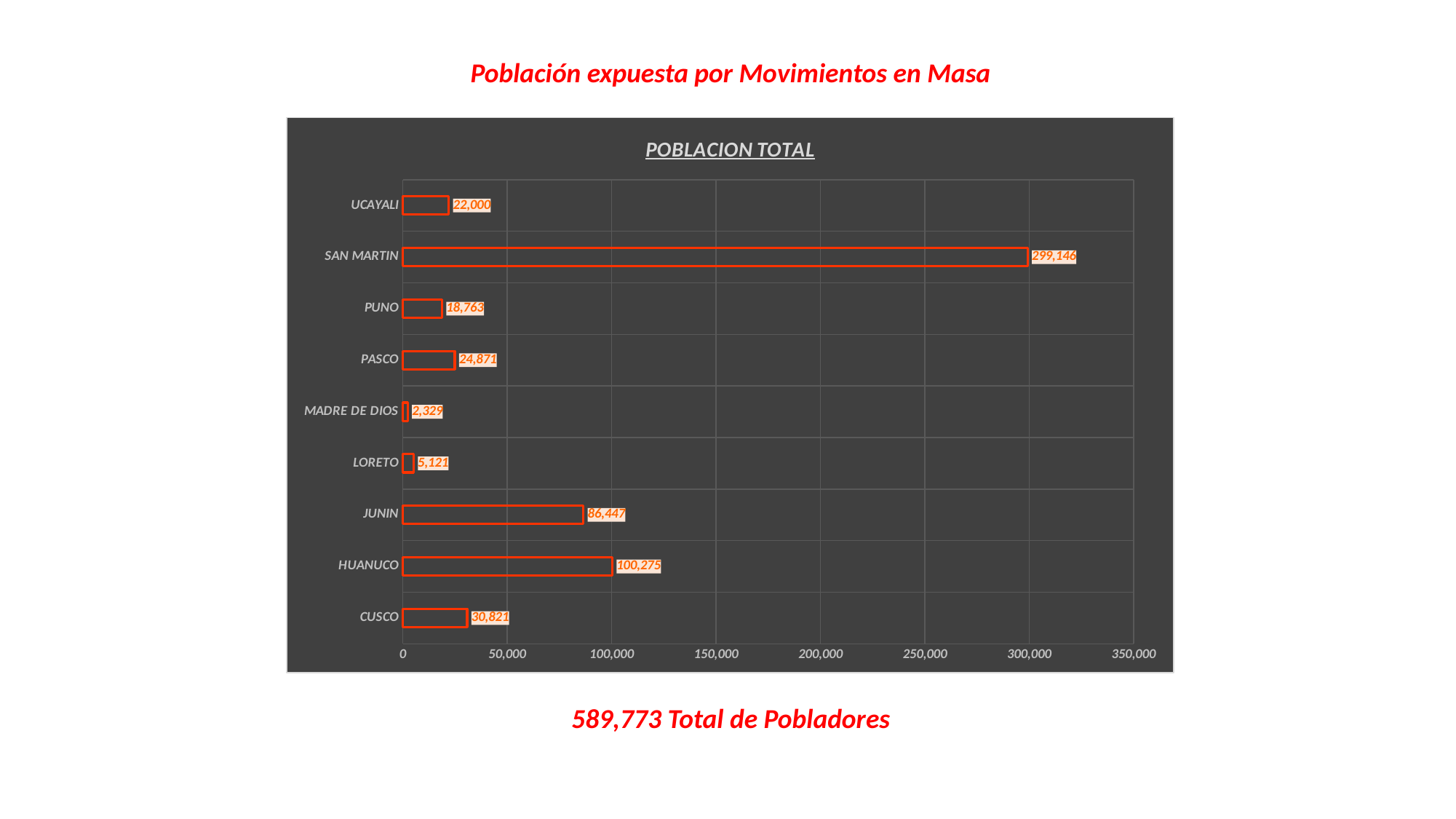
What kind of chart is shown on the slide? bar chart What is the value for SAN MARTIN? 299,146 What is the difference between the values for CUSCO and PUNO? 12,058 Which category has the lowest value? MADRE DE DIOS Which is larger, the value for PASCO or the value for UCAYALI? PASCO What is the title of the chart? POBLACION TOTAL What is the value for HUANUCO? 100,275 What is the value for MADRE DE DIOS? 2,329 Which category has the highest value? SAN MARTIN What is the difference between the values for HUANUCO and JUNIN? 13,828 Is the value for JUNIN greater or less than 100,000? less How many categories are shown in the chart? 9